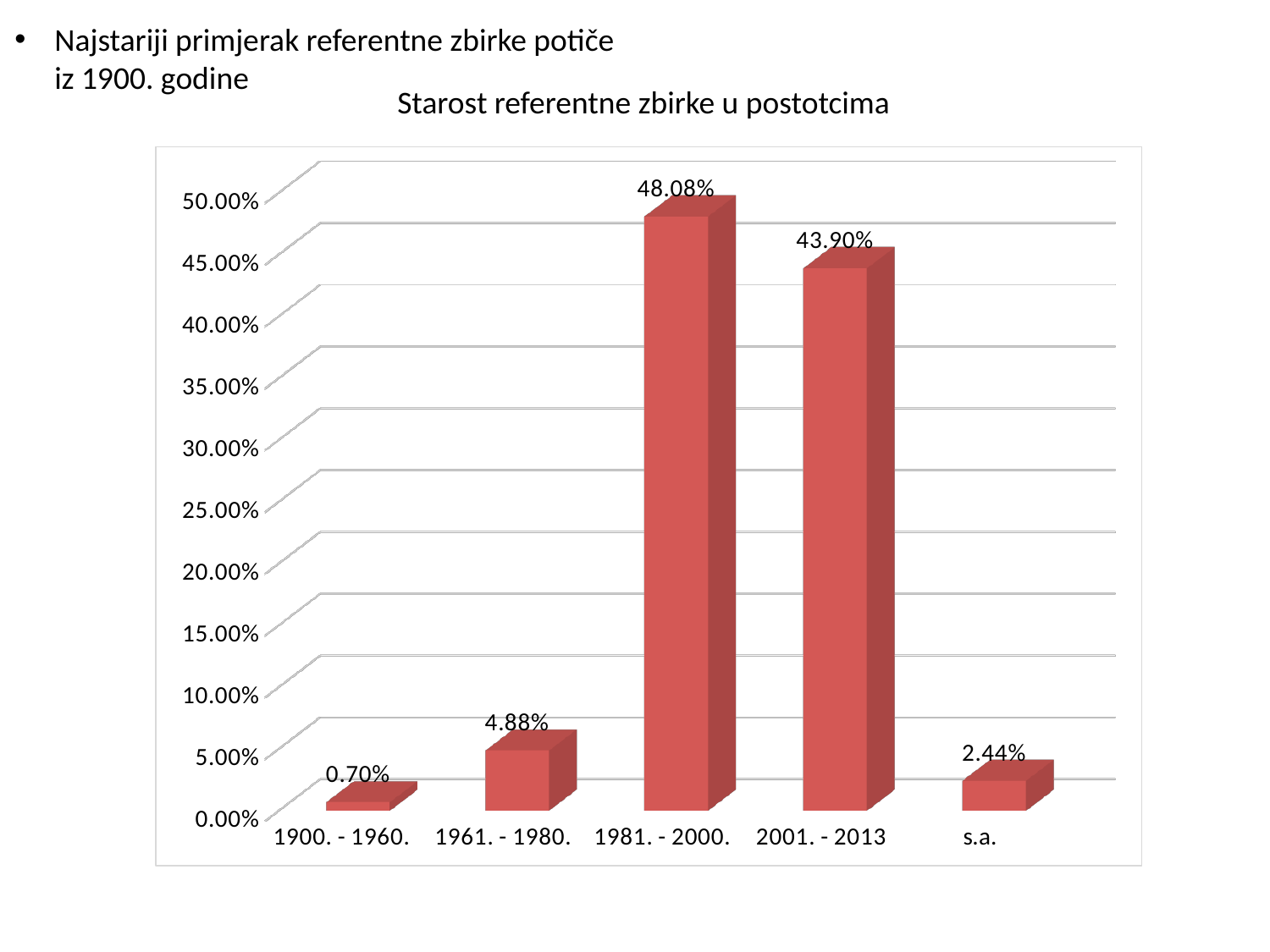
What is the value for 1981. - 2000.? 48.08% What kind of chart is shown? bar chart What is the value for s.a.? 2.44% Which category has the lowest value? 1900. - 1960. What is the value for 2001. - 2013? 43.90% Which category has the highest value? 1981. - 2000. What is the value for 1900. - 1960.? 0.70% Is the value for 2001. - 2013 greater or less than 40.00%? greater How many categories are shown on the x axis? 5 Which is larger, the value for 1961. - 1980. or the value for s.a.? 1961. - 1980. What is the difference between the values for 1981. - 2000. and 2001. - 2013? 4.18% What is the title of the chart? Starost referentne zbirke u postotcima